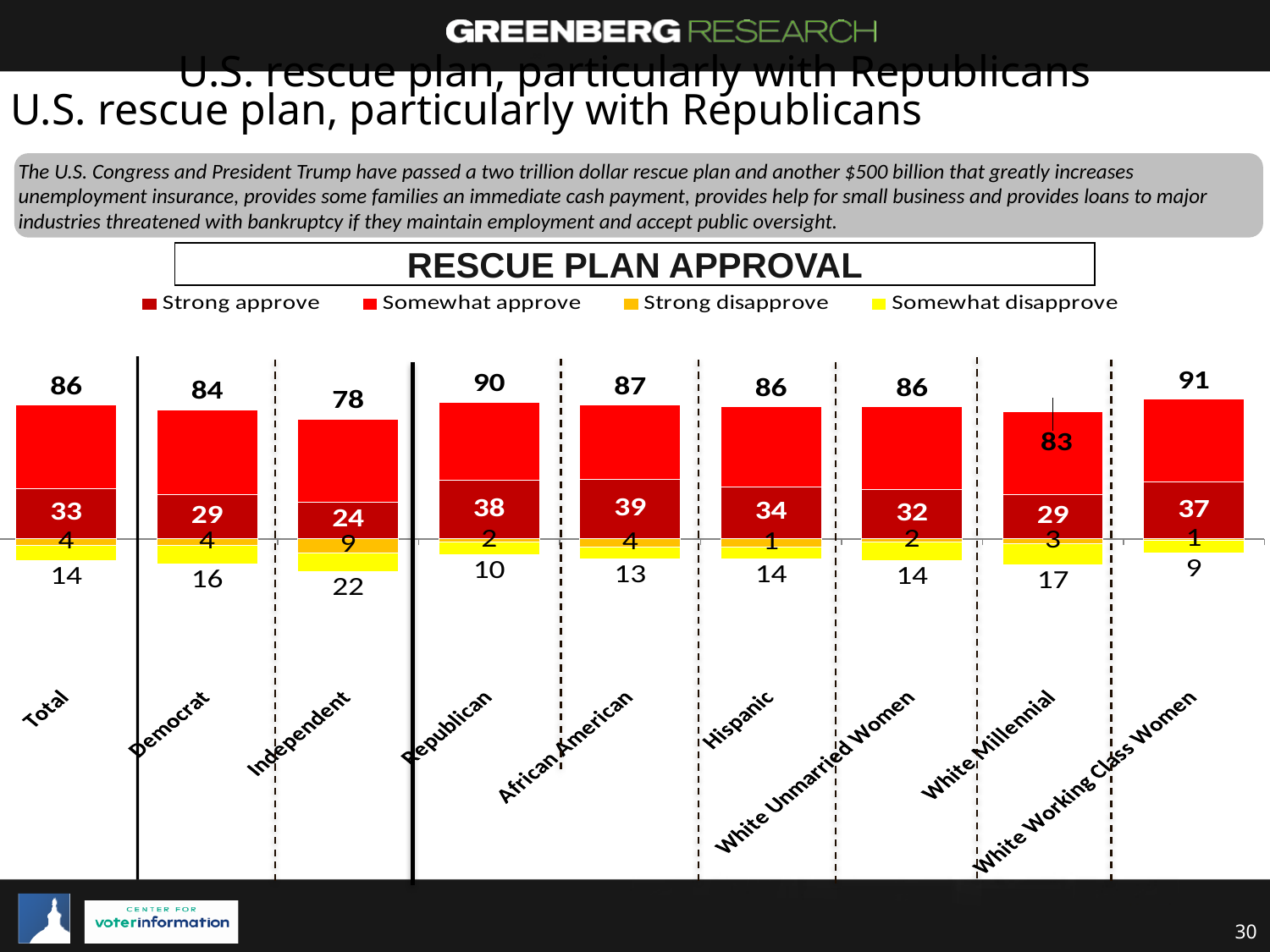
What kind of chart is shown? Stacked bar chart What is the Strong approve value for African American? 39 How many categories are shown on the x axis? 9 Which has a higher Strong approve value, African American or Hispanic? African American How many series does the legend list? 4 What is the difference between the total approval values for Republican and Independent? 12 What is the title of the chart? RESCUE PLAN APPROVAL What is the disapproval value shown below the bar for Independent? 22 Which category has the lowest total approval value? Independent Which category has the highest Strong approve value? African American What is the total approval value shown above the bar for Republican? 90 Which category has the highest total approval value? White Working Class Women